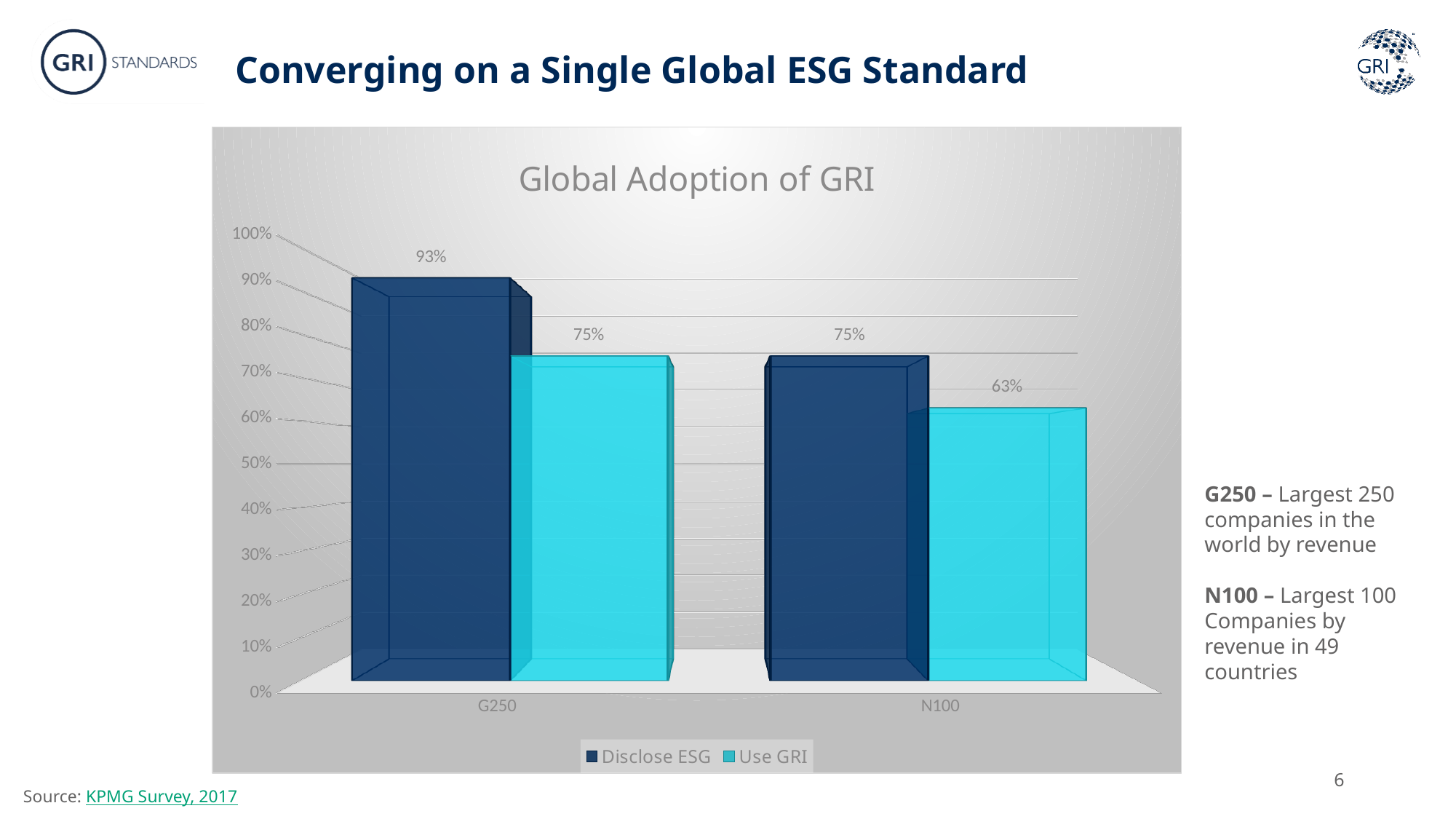
How many series does the legend list? 2 Which category has the highest Disclose ESG value? G250 What is the value for Use GRI for N100? 63% Which category has the lowest Use GRI value? N100 What is the difference between Disclose ESG and Use GRI for N100? 12% Which is larger: Use GRI for G250 or Use GRI for N100? Use GRI for G250 What is the value for Disclose ESG for G250? 93% What is the difference between Disclose ESG and Use GRI for G250? 18% What kind of chart is shown on the slide? Bar chart What is the value for Disclose ESG for N100? 75% What is the value for Use GRI for G250? 75% How many categories are shown on the x axis? 2